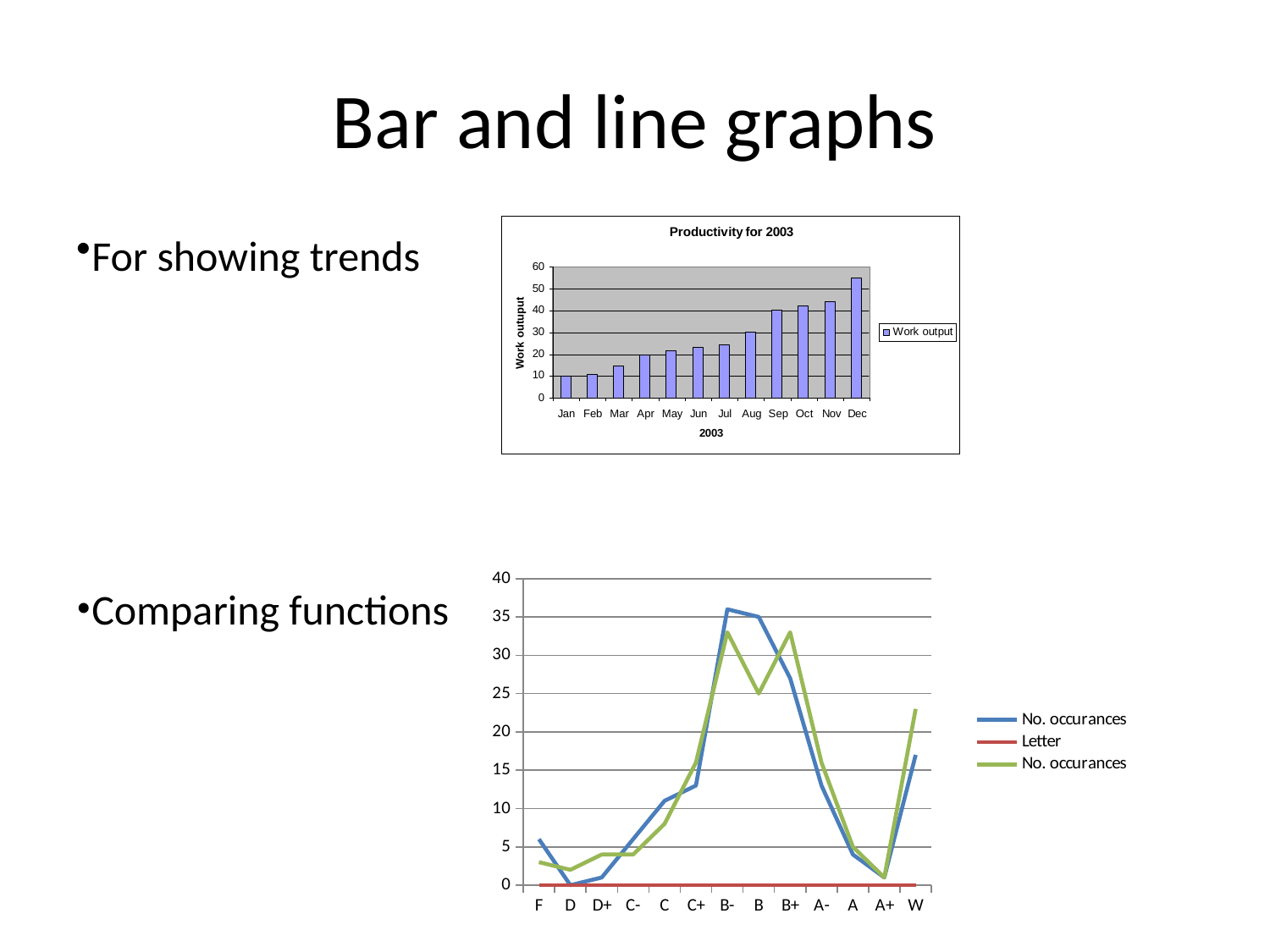
How many letter grade categories are on the x axis of the bottom chart? 13 In the bottom chart, at B+, which line is higher: the blue 'No. occurances' line or the green 'No. occurances' line? the green line What kind of chart is the chart at the bottom of the slide? line chart How many months are shown on the x axis of the 'Productivity for 2003' chart? 12 In the 'Productivity for 2003' chart, is the value for Sep greater or less than 30? greater In the 'Productivity for 2003' chart, do the values generally rise or fall from Jan to Dec? rise How many series does the legend of the 'Productivity for 2003' chart list? 1 In the 'Productivity for 2003' chart, which month has the highest work output? Dec In the 'Productivity for 2003' chart, is the value for Mar greater or less than 20? less In the bottom chart, is the value of the blue 'No. occurances' line at B- greater or less than 35? greater What kind of chart is the 'Productivity for 2003' chart at the top of the slide? bar chart How many series does the legend of the bottom chart list? 3